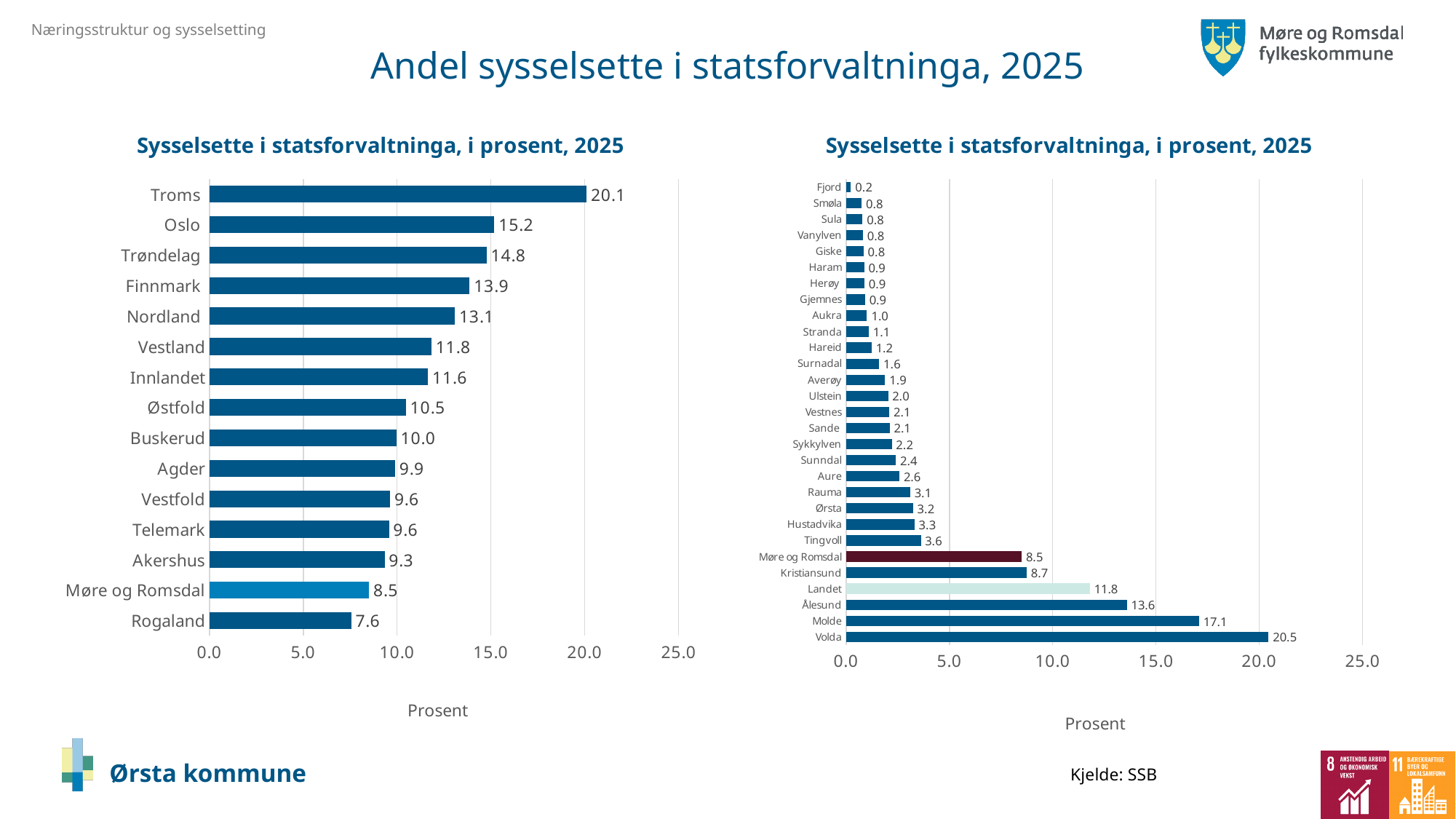
In the left chart, what is the value for Troms? 20.1 What kind of chart is the left chart? Bar chart In the right chart, how many categories are shown? 29 In the right chart, what is the value for Volda? 20.5 In the right chart, what is the difference between Volda and Molde? 3.4 In the right chart, what is the value for Landet? 11.8 In the right chart, which category has the lowest value? Fjord In the left chart, what is the difference between Oslo and Trøndelag? 0.4 In the left chart, how many categories are shown? 15 In the right chart, which is larger, Molde or Ålesund? Molde In the left chart, which category has the lowest value? Rogaland In the left chart, what is the value for Møre og Romsdal? 8.5